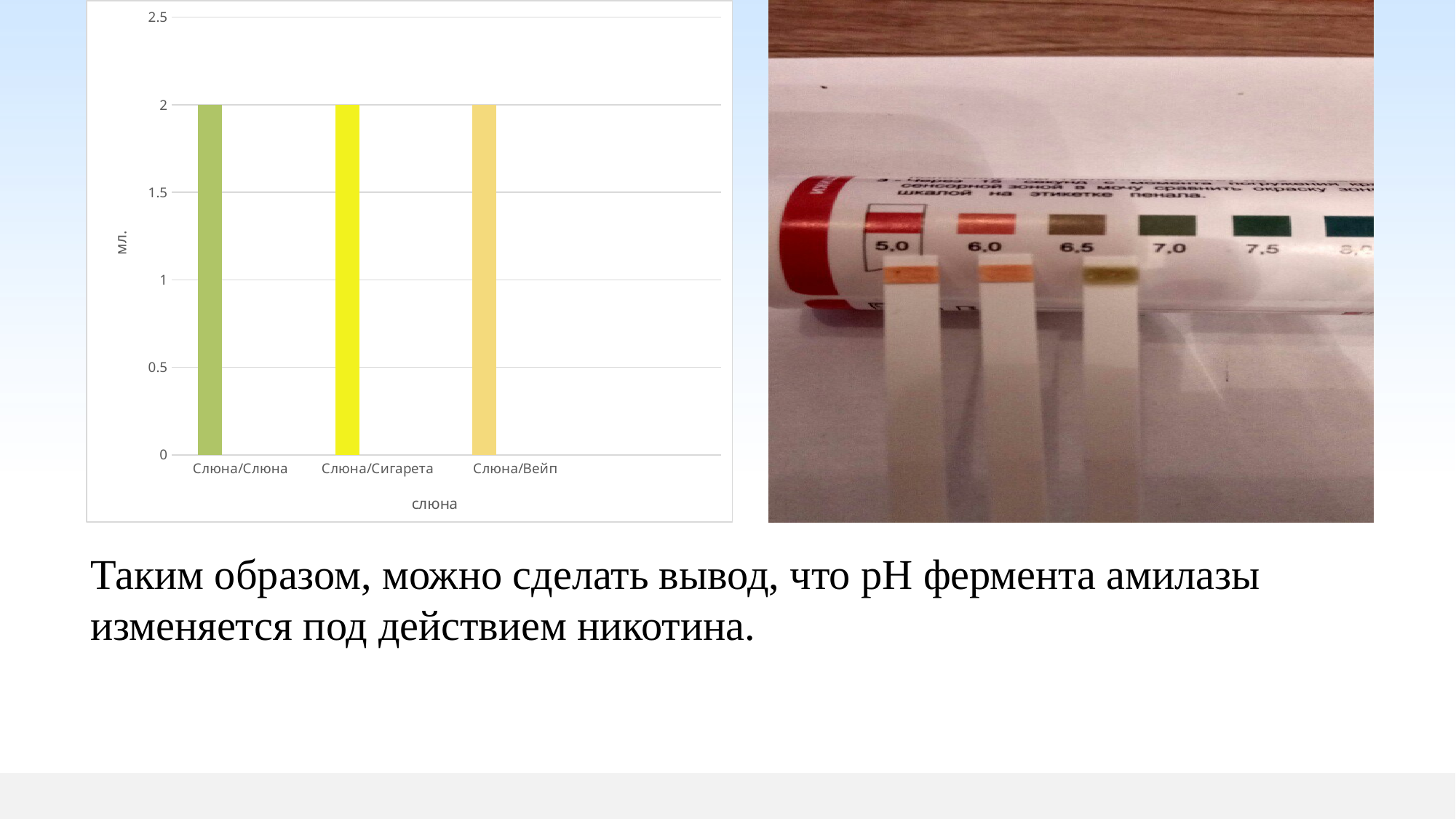
Is the value for Слюна/Сигарета greater or less than 1.5? greater What is the value for Слюна/Вейп in the bar chart? 2 What is the difference between the values for Слюна/Слюна and Слюна/Вейп? 0 What is the label of the x axis of the bar chart? слюна How many categories are shown on the x axis of the bar chart? 3 What is the value for Слюна/Слюна in the bar chart? 2 What is the value for Слюна/Сигарета in the bar chart? 2 Do the values rise, fall, or stay the same across the categories from left to right? stay the same What is the label of the y axis of the bar chart? мл. Is the value for Слюна/Вейп greater or less than 2.5? less What kind of chart is shown on the left of the slide? bar chart